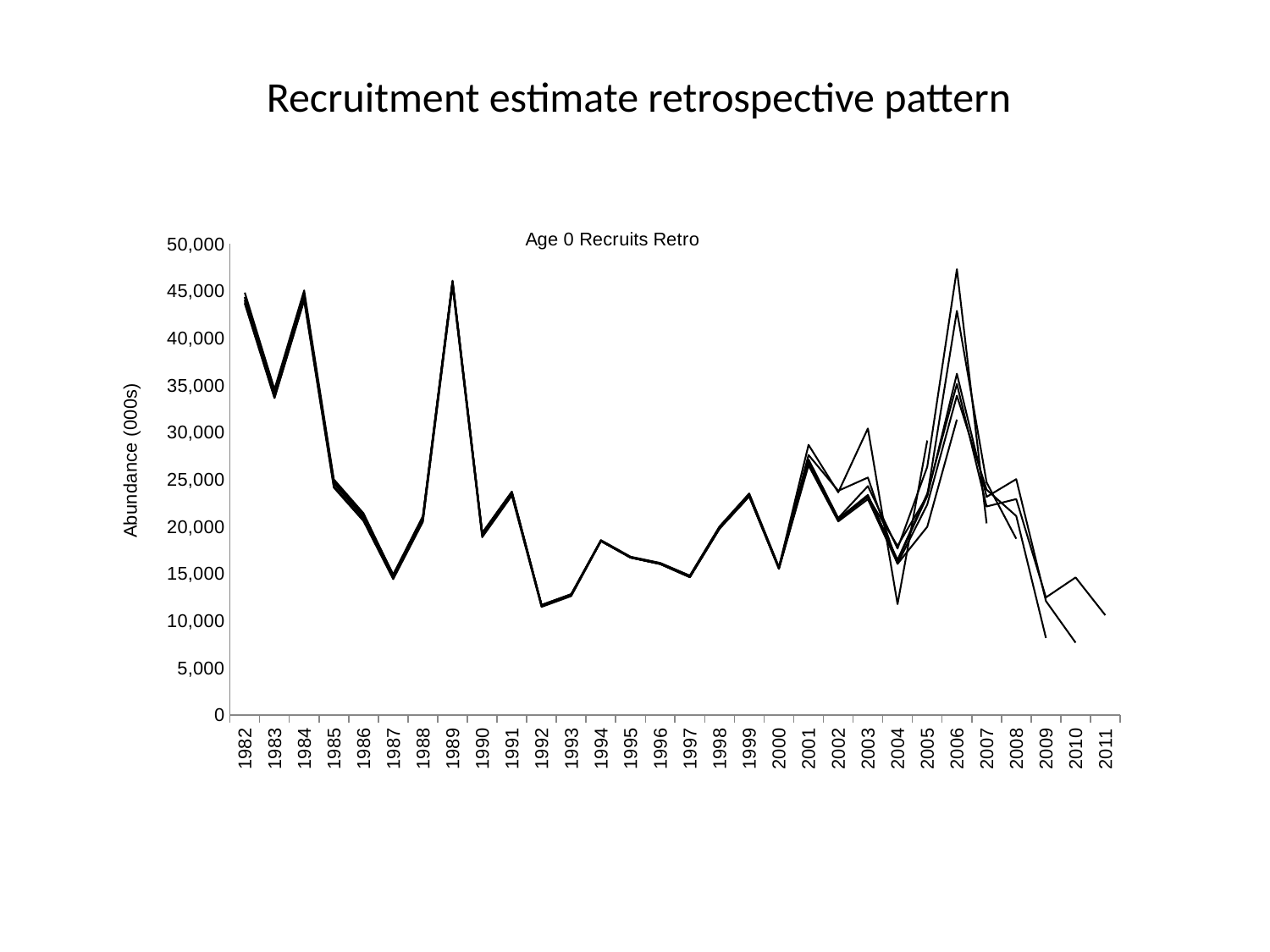
What is the label on the vertical axis of the chart? Abundance (000s) Is the value for 2000 greater or less than 20,000? less Is the value for 1989 greater or less than 40,000? greater What is the title printed above the chart's plot area? Age 0 Recruits Retro Do the values rise or fall from 1984 to 1987? fall Which year has the larger value, 1984 or 1985? 1984 Is the value for 1982 greater or less than 40,000? greater What kind of chart is shown on the slide? line chart How many years are labelled along the x axis of the chart? 30 Which year has the larger value, 1989 or 1992? 1989